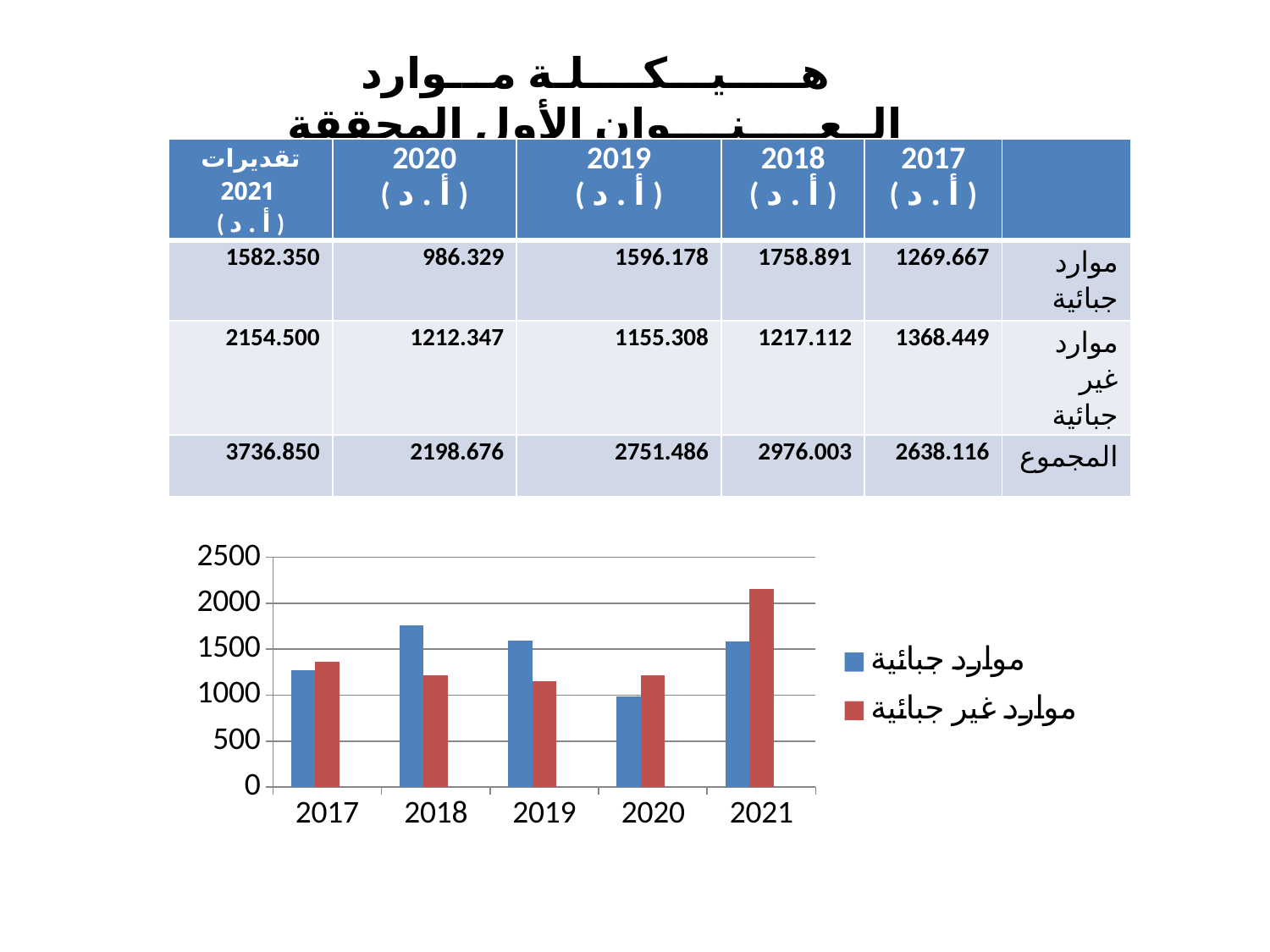
In which year is the bar for موارد غير جبائية the highest? 2021 In which year is the bar for موارد جبائية the highest? 2018 Does the bar for موارد جبائية rise or fall from 2017 to 2018? rise In which year is the bar for موارد جبائية the lowest? 2020 How many series does the chart legend list? 2 How many years are shown on the x axis of the chart? 5 What kind of chart is shown on the slide? bar chart Is the value for موارد غير جبائية in 2021 greater or less than 2000? greater According to the table, what is the value of موارد جبائية for 2019? 1596.178 In 2018, which series has the larger bar, موارد جبائية or موارد غير جبائية? موارد جبائية Is the value for موارد جبائية in 2018 greater or less than 1500? greater In 2021, which series has the larger bar, موارد جبائية or موارد غير جبائية? موارد غير جبائية